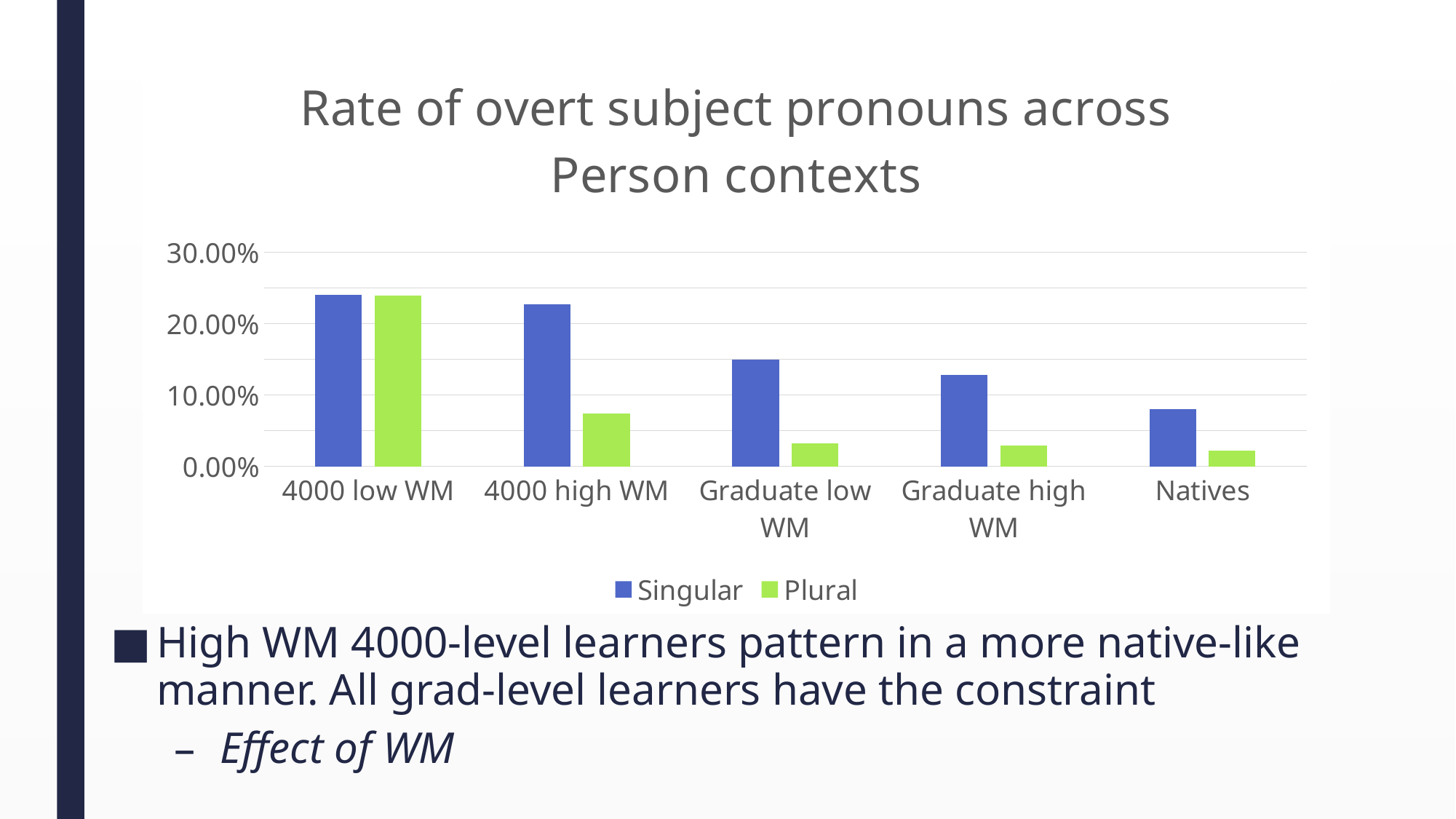
Is the Singular value for Natives greater or less than 10.00%? less Which category has the highest Plural value? 4000 low WM Is the Plural value for 4000 high WM greater or less than 10.00%? less How many series does the chart's legend list? 2 Is the Singular value for Graduate low WM greater or less than 10.00%? greater Which colour represents the Plural series in the chart? green What kind of chart is shown on the slide? bar chart Which category has the lowest Singular value? Natives What is the title of the chart? Rate of overt subject pronouns across Person contexts For 4000 high WM, which is larger, the Singular value or the Plural value? Singular How many categories are shown on the x axis of the chart? 5